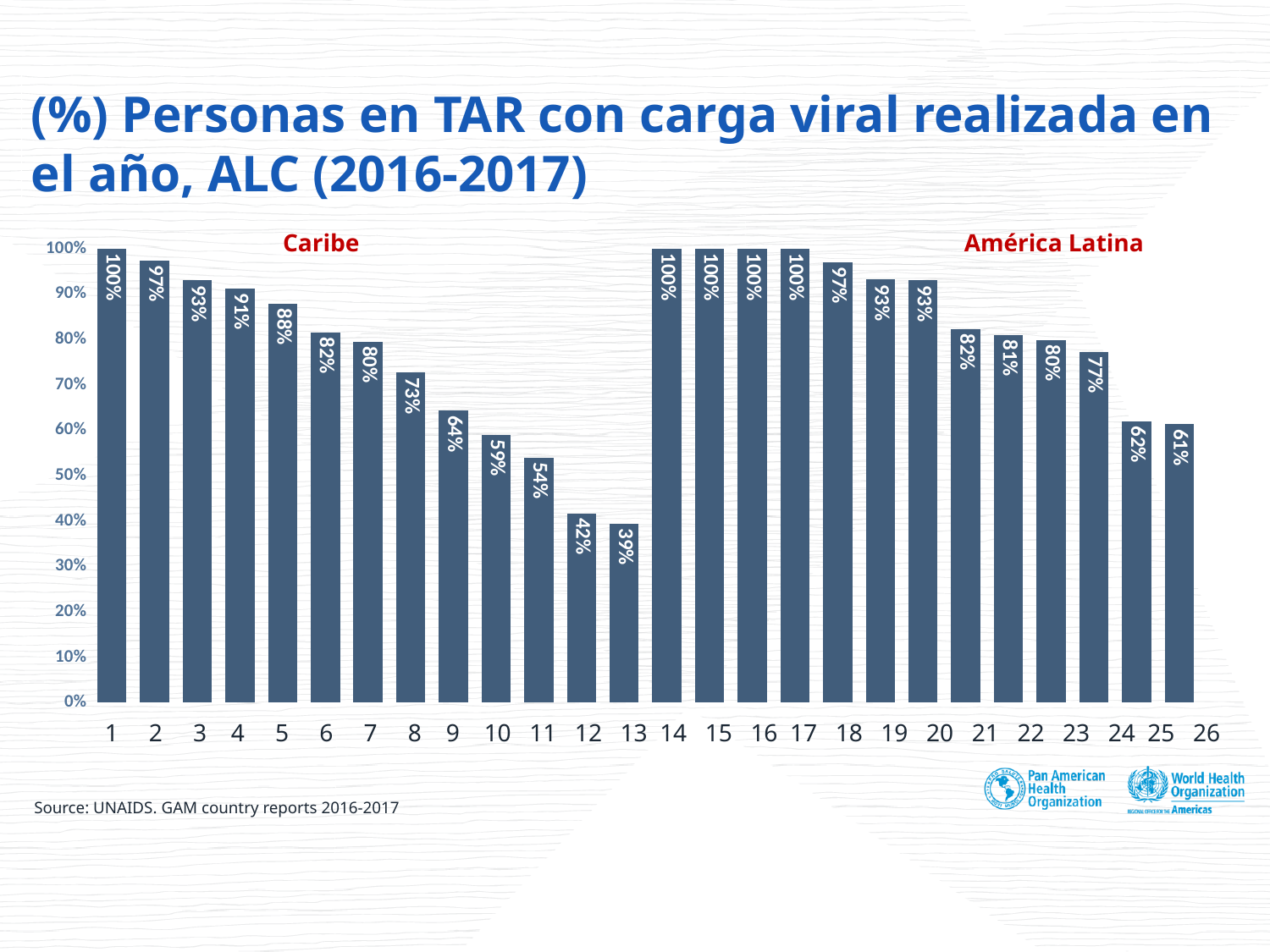
What is the value for category 24? 62% What is the difference between the values for category 1 and category 13? 61% How many categories have a value of 100%? 5 What is the value for category 8? 73% Which is larger, the value for category 9 or the value for category 22? 22 Do the values rise or fall from category 14 to category 26? fall What is the value for category 13? 39% How many categories are shown on the x axis? 26 What are the two group labels shown above the bars? Caribe and América Latina What kind of chart is shown on the slide? bar chart What is the difference between the values for category 21 and category 25? 21% Which category has the lowest value? 13